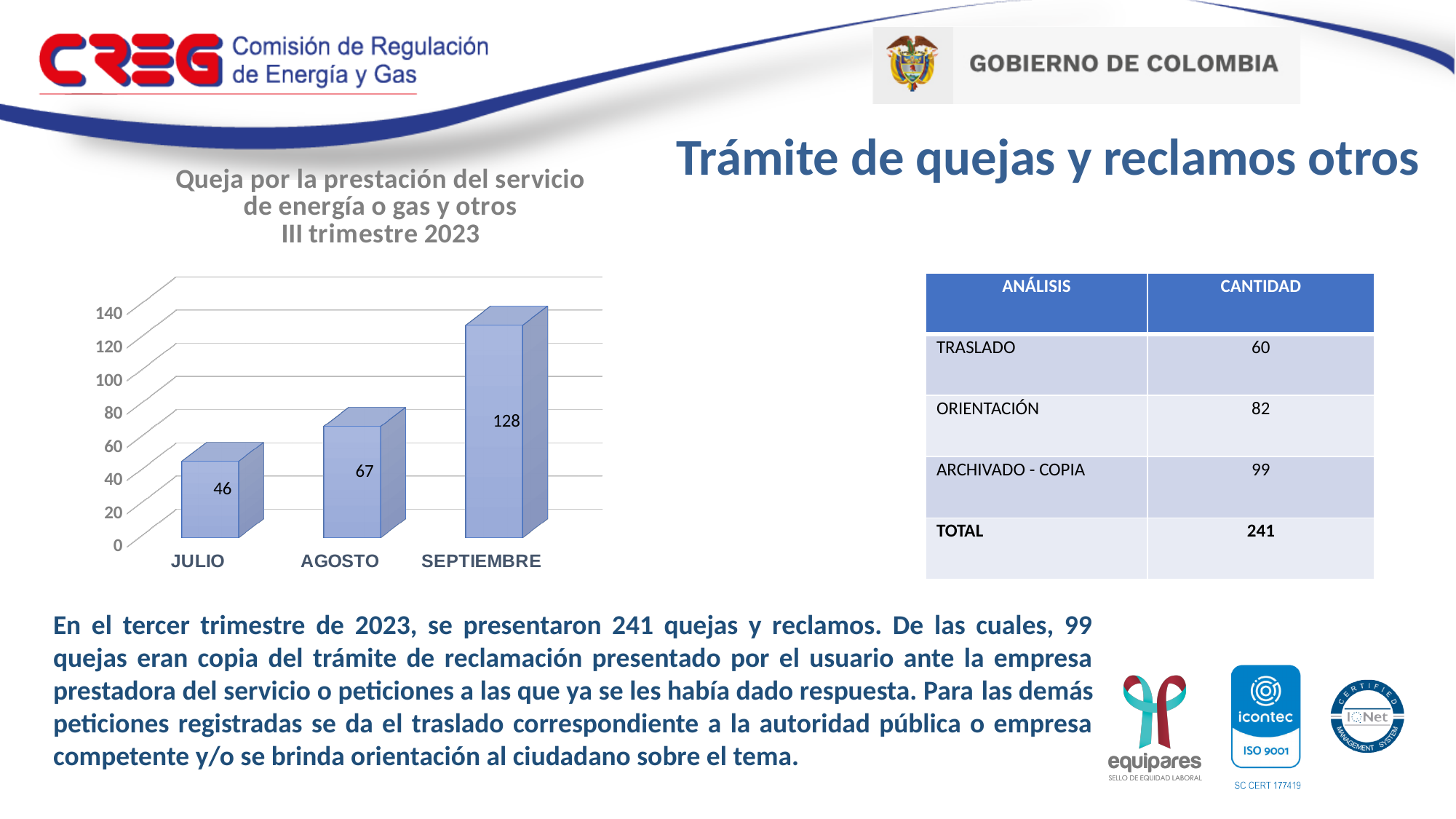
Which month has the lowest value? JULIO Do the values rise or fall from JULIO to SEPTIEMBRE? rise What is the difference between the values for AGOSTO and JULIO? 21 What kind of chart is shown on the slide? bar chart Which month has the highest value? SEPTIEMBRE Which is larger, the value for AGOSTO or the value for JULIO? AGOSTO What is the value for JULIO? 46 Is the value for SEPTIEMBRE greater or less than 100? greater How many months are shown on the x axis of the chart? 3 What is the difference between the values for SEPTIEMBRE and JULIO? 82 What is the value for AGOSTO? 67 What is the value for SEPTIEMBRE? 128